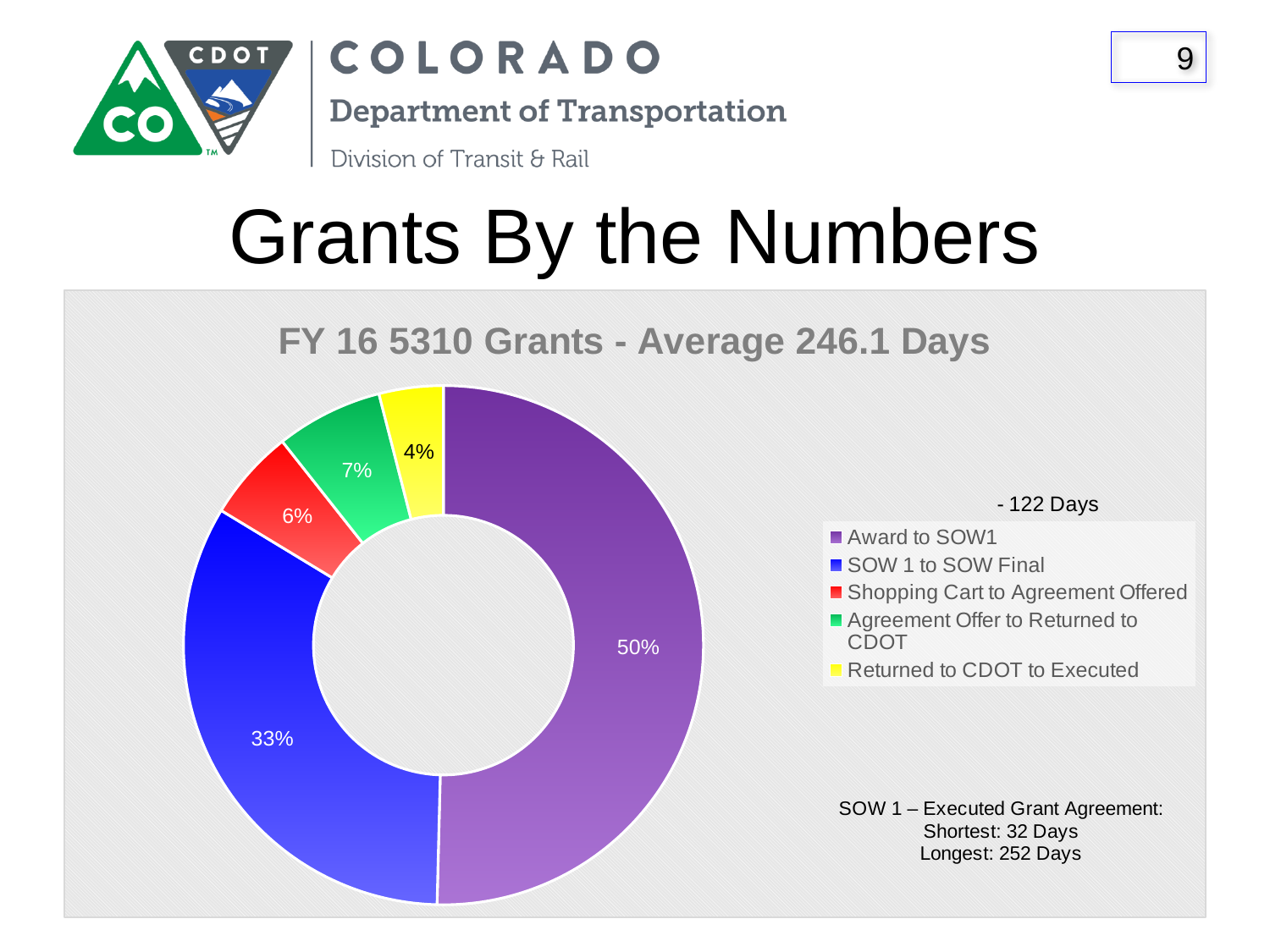
What share of the chart does SOW 1 to SOW Final represent? 33% What is the title of the chart? FY 16 5310 Grants - Average 246.1 Days Which category has the smallest slice of the chart? Returned to CDOT to Executed What share of the chart does Agreement Offer to Returned to CDOT represent? 7% What kind of chart is shown on the slide? Doughnut (pie) chart Which slice is larger: Agreement Offer to Returned to CDOT or Shopping Cart to Agreement Offered? Agreement Offer to Returned to CDOT Which category has the largest slice of the chart? Award to SOW1 What share of the chart does Award to SOW1 represent? 50% How many categories does the legend list? 5 What is the difference in percentage points between the Award to SOW1 slice and the SOW 1 to SOW Final slice? 17 percentage points